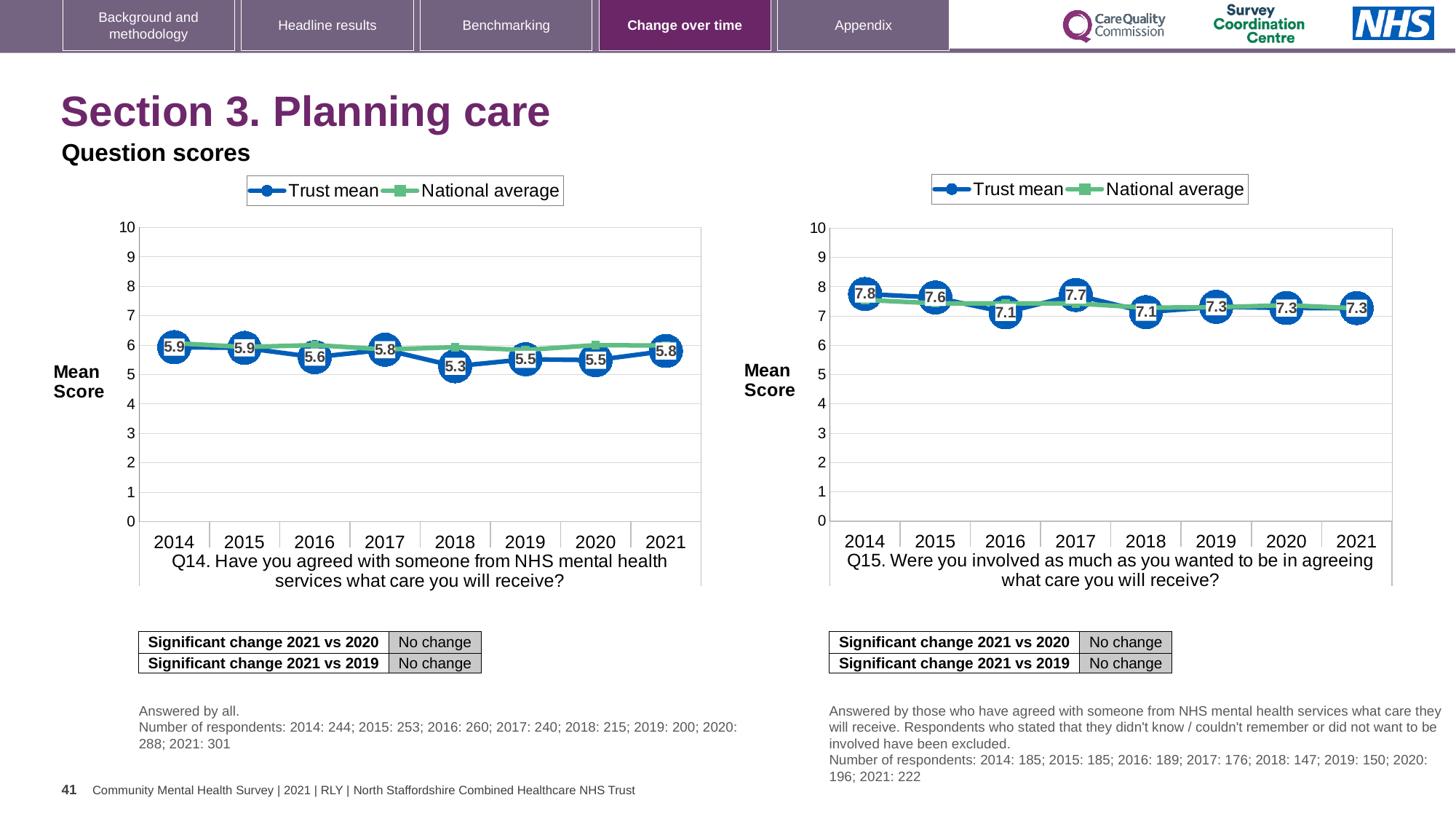
In the Q15 chart on the right, what is the Trust mean for 2014? 7.8 In the Q15 chart on the right, what is the Trust mean for 2017? 7.7 How many series does the legend of the Q14 chart on the left list? 2 What kind of chart is the Q15 chart on the right? Line chart In the Q14 chart on the left, which year has the lowest Trust mean? 2018 In the Q15 chart on the right, which year has the highest Trust mean? 2014 In the Q14 chart on the left, what is the Trust mean for 2018? 5.3 In the Q15 chart on the right, what is the difference between the Trust mean for 2014 and for 2021? 0.5 In the Q15 chart on the right, is the Trust mean for 2015 larger or smaller than the Trust mean for 2016? larger In the Q14 chart on the left, how many years are plotted on the x axis? 8 In the Q14 chart on the left, what is the Trust mean for 2021? 5.8 In the Q14 chart on the left, what is the difference between the Trust mean for 2014 and for 2018? 0.6